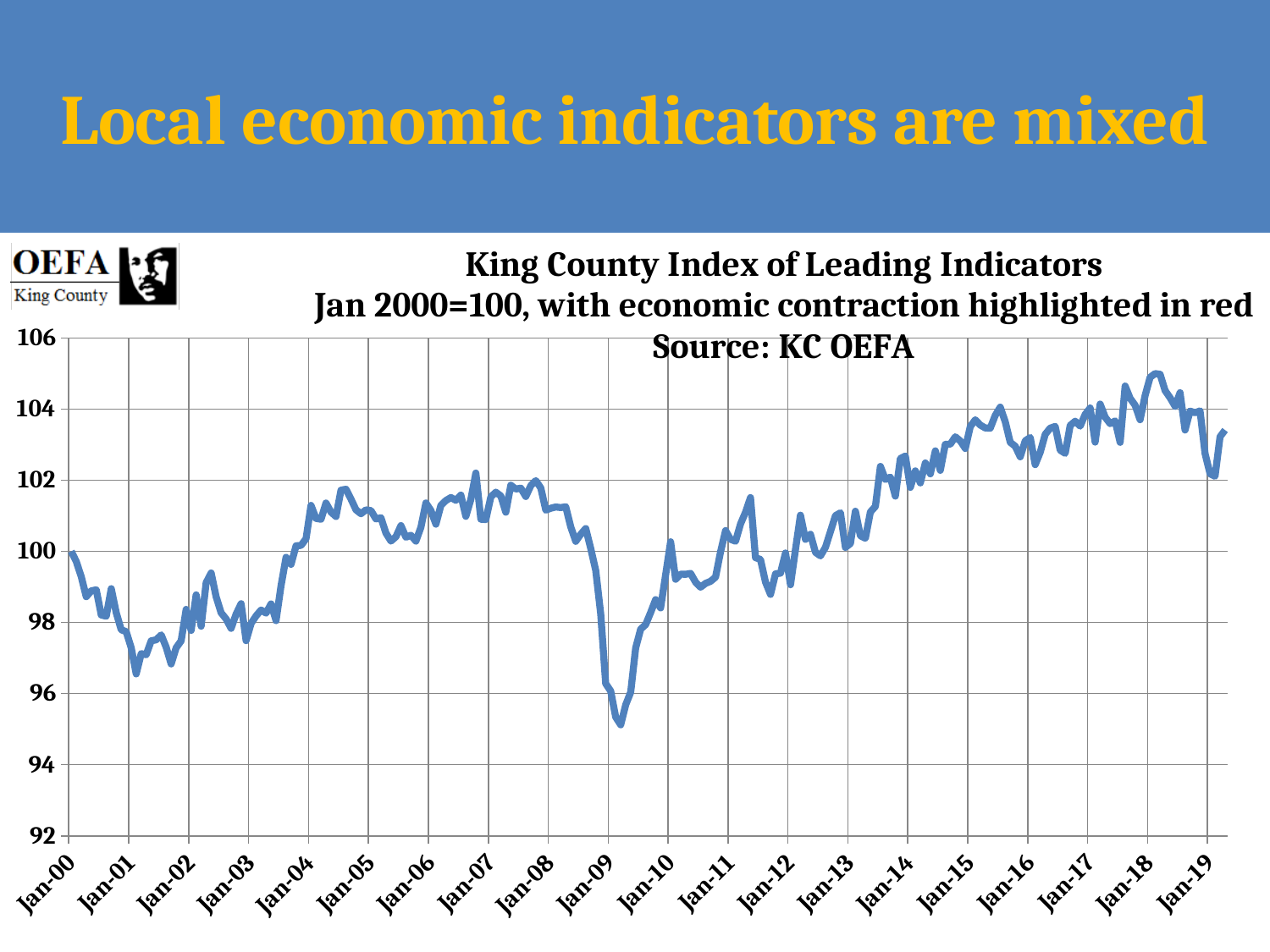
What is the title of the chart? King County Index of Leading Indicators Is the index value at Jan-18 greater or less than 104? greater Is the index value at Jan-05 greater or less than 100? greater Is the index value at Jan-12 greater or less than 100? less What is the source given for the chart? KC OEFA Around which year does the index reach its lowest point? 2009 What kind of chart is shown on the slide? line chart Does the index rise or fall between Jan-09 and Jan-18? rise Around which year does the index reach its highest point? 2018 What is the index value in Jan 2000, the base period? 100